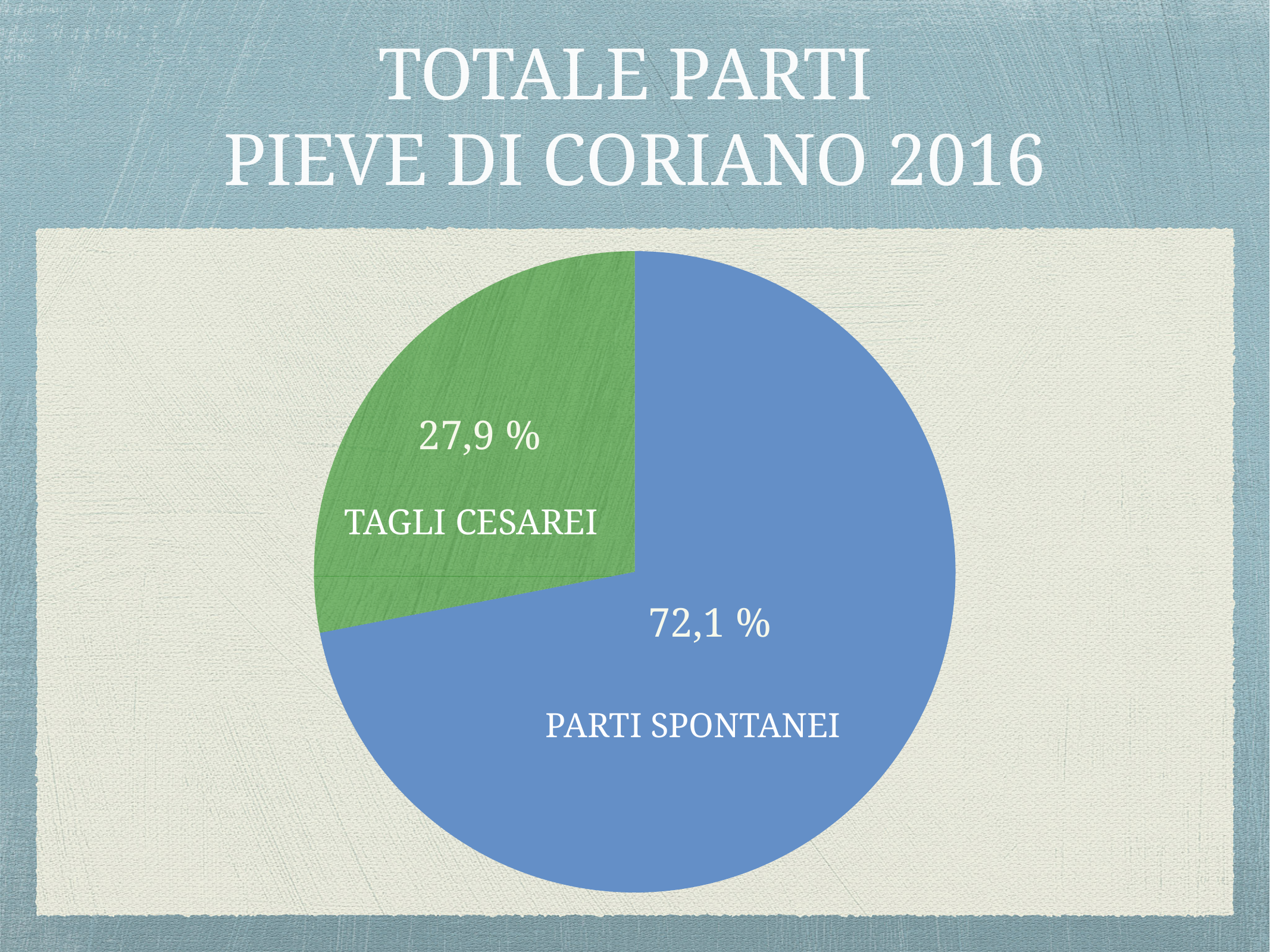
Which is larger, the share for TAGLI CESAREI or the share for PARTI SPONTANEI? PARTI SPONTANEI What kind of chart is shown on the slide? Pie chart What is the title of the slide containing the chart? TOTALE PARTI PIEVE DI CORIANO 2016 What colour is the PARTI SPONTANEI slice? Blue What percentage of the pie is labelled TAGLI CESAREI? 27,9 % How many slices does the pie chart have? 2 Which slice of the pie is the smallest? TAGLI CESAREI What is the difference in percentage points between PARTI SPONTANEI and TAGLI CESAREI? 44,2 What percentage of the pie is labelled PARTI SPONTANEI? 72,1 % Which slice of the pie is the largest? PARTI SPONTANEI What share of the pie does the TAGLI CESAREI slice represent? 27,9 %